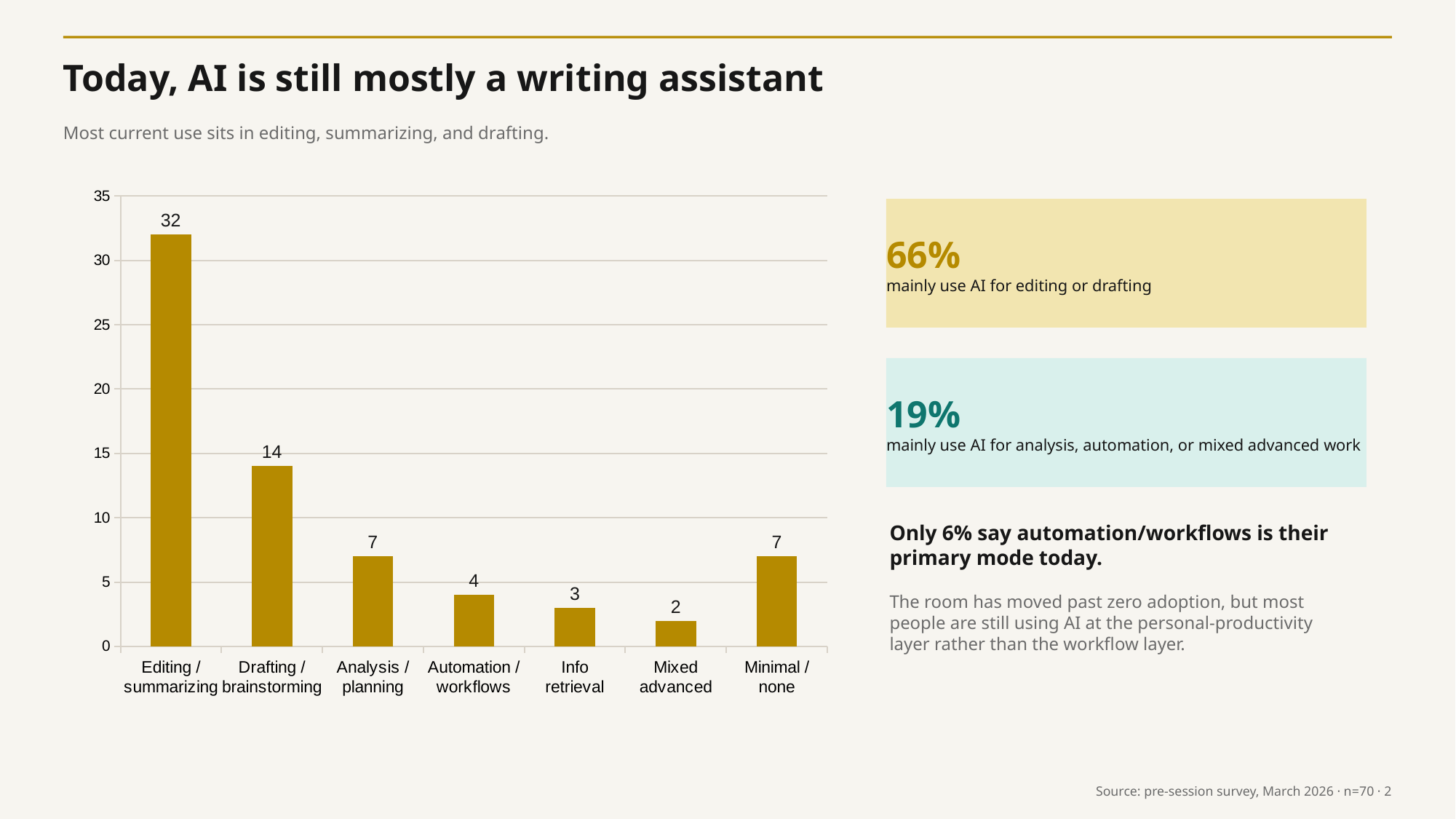
What kind of chart is shown on the slide? Bar chart Which is larger, Info retrieval or Minimal / none? Minimal / none Which category has the lowest value? Mixed advanced What is the value for Mixed advanced? 2 What is the maximum value shown on the y axis? 35 What is the value for Drafting / brainstorming? 14 How many categories are shown on the x axis? 7 What is the value for Editing / summarizing? 32 What is the value for Automation / workflows? 4 Which category has the highest value? Editing / summarizing What is the difference between Editing / summarizing and Drafting / brainstorming? 18 Is the value for Drafting / brainstorming greater or less than 10? greater